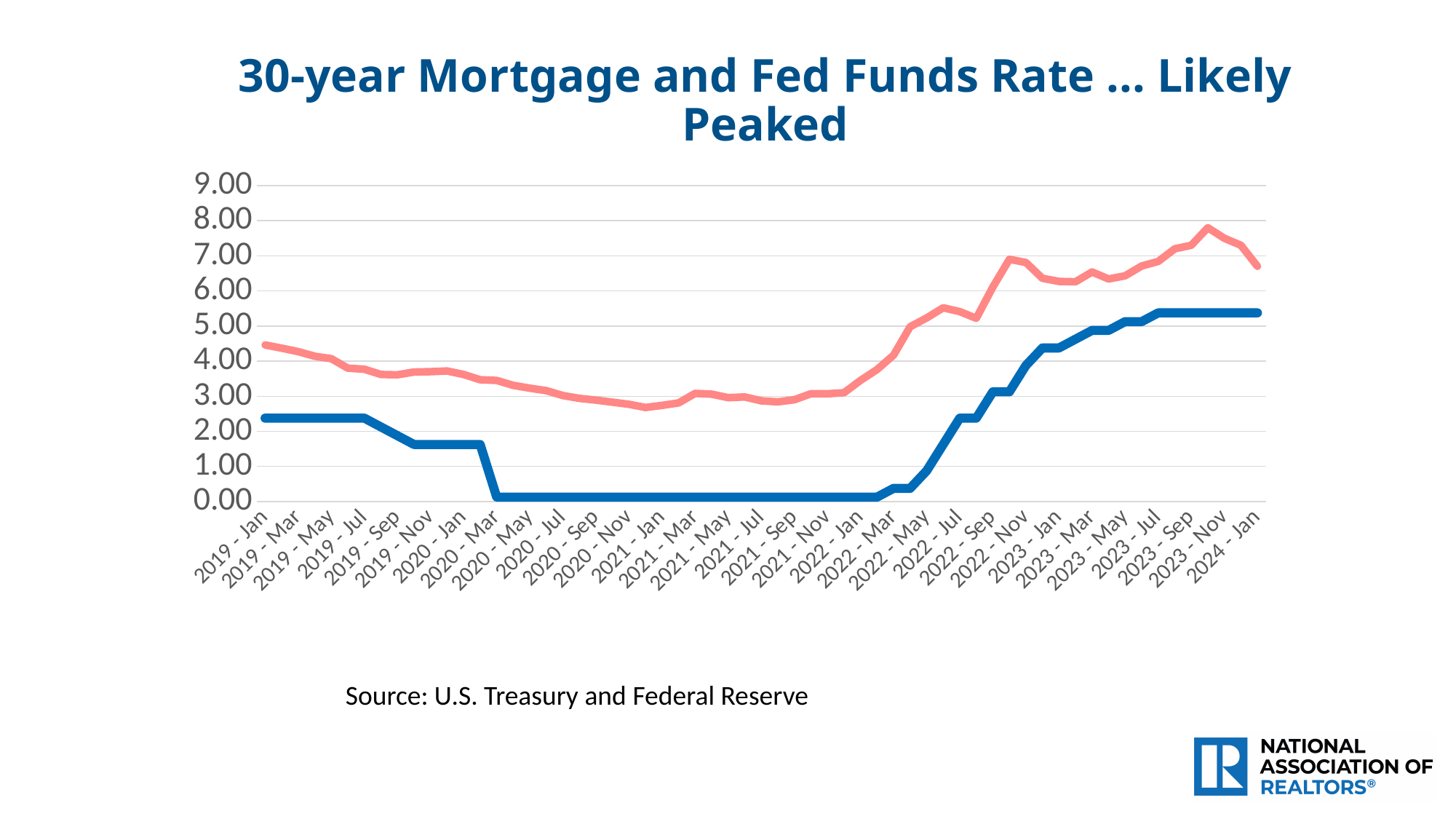
What source is cited below the chart? U.S. Treasury and Federal Reserve Does the pink line rise or fall between 2019 - Jan and 2021 - Jan? fall Is the value of the blue line at 2024 - Jan greater or less than 5.00? greater Is the value of the pink line at 2021 - Jan greater or less than 3.00? less Is the value of the blue line at 2020 - May greater or less than 1.00? less At 2022 - Nov, which line has the higher value, the pink line or the blue line? the pink line How many lines are plotted on the chart? 2 What is the title of the chart? 30-year Mortgage and Fed Funds Rate ... Likely Peaked Does the blue line rise or fall between 2022 - Mar and 2023 - Jul? rise What kind of chart is shown on the slide? line chart